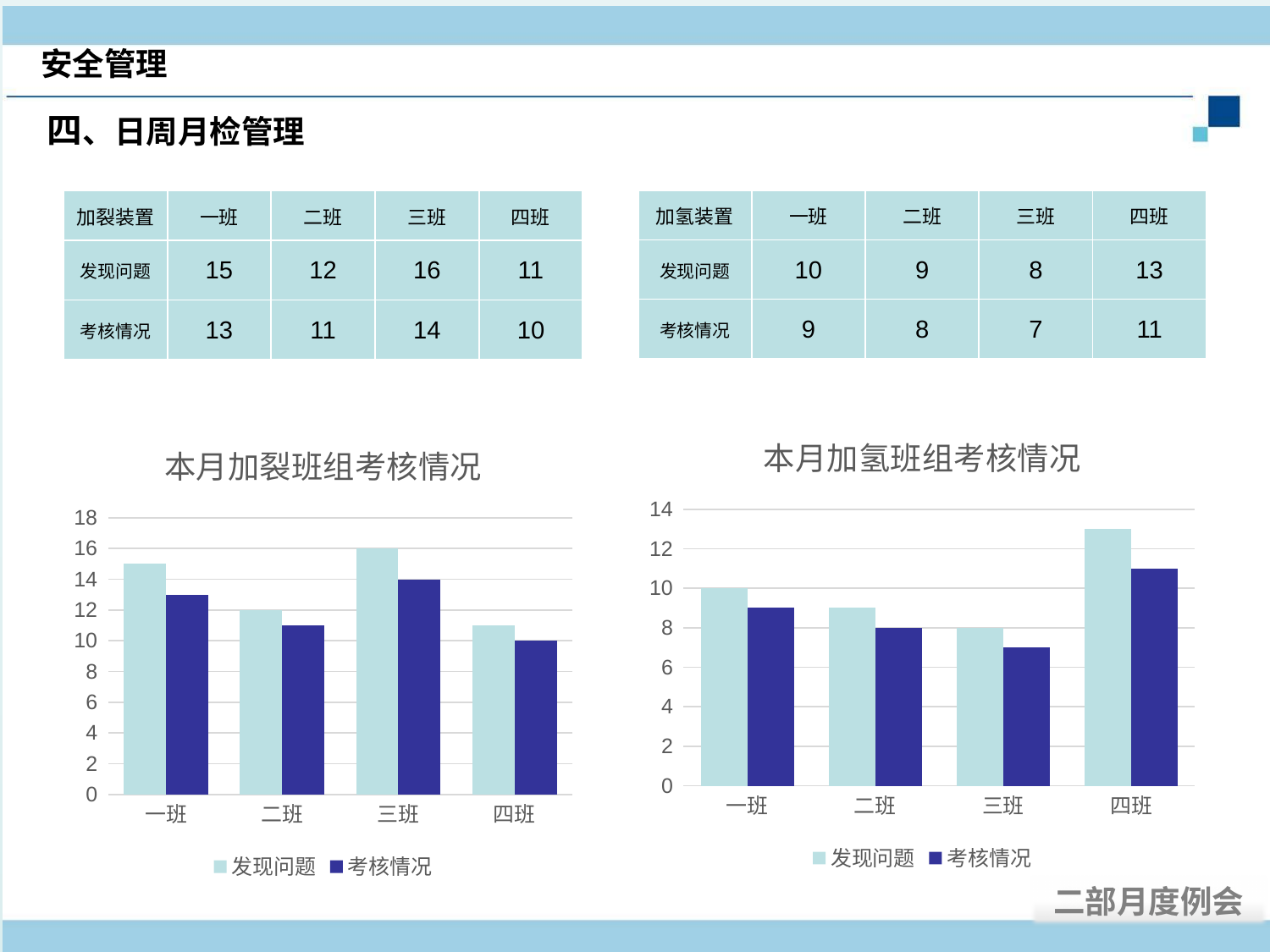
In the chart titled 本月加裂班组考核情况, is the 考核情况 value for 四班 greater or less than 12? less In the chart titled 本月加裂班组考核情况, what is the difference between 发现问题 and 考核情况 for 一班? 2 In the chart titled 本月加氢班组考核情况, which category has the lowest 考核情况 value? 三班 In the chart titled 本月加氢班组考核情况, which is larger: 发现问题 for 四班 or 发现问题 for 一班? 发现问题 for 四班 In the chart titled 本月加裂班组考核情况, what is the value of 发现问题 for 三班? 16 In the chart titled 本月加氢班组考核情况, what is the value of 考核情况 for 四班? 11 How many series does the legend of the chart titled 本月加裂班组考核情况 list? 2 In the chart titled 本月加裂班组考核情况, which category has the highest 发现问题 value? 三班 In the chart titled 本月加氢班组考核情况, does the 考核情况 series rise or fall from 一班 to 三班? fall How many categories are shown on the x axis of the chart titled 本月加氢班组考核情况? 4 What kind of chart is the chart titled 本月加氢班组考核情况? bar chart What is the title of the chart on the left side of the slide? 本月加裂班组考核情况